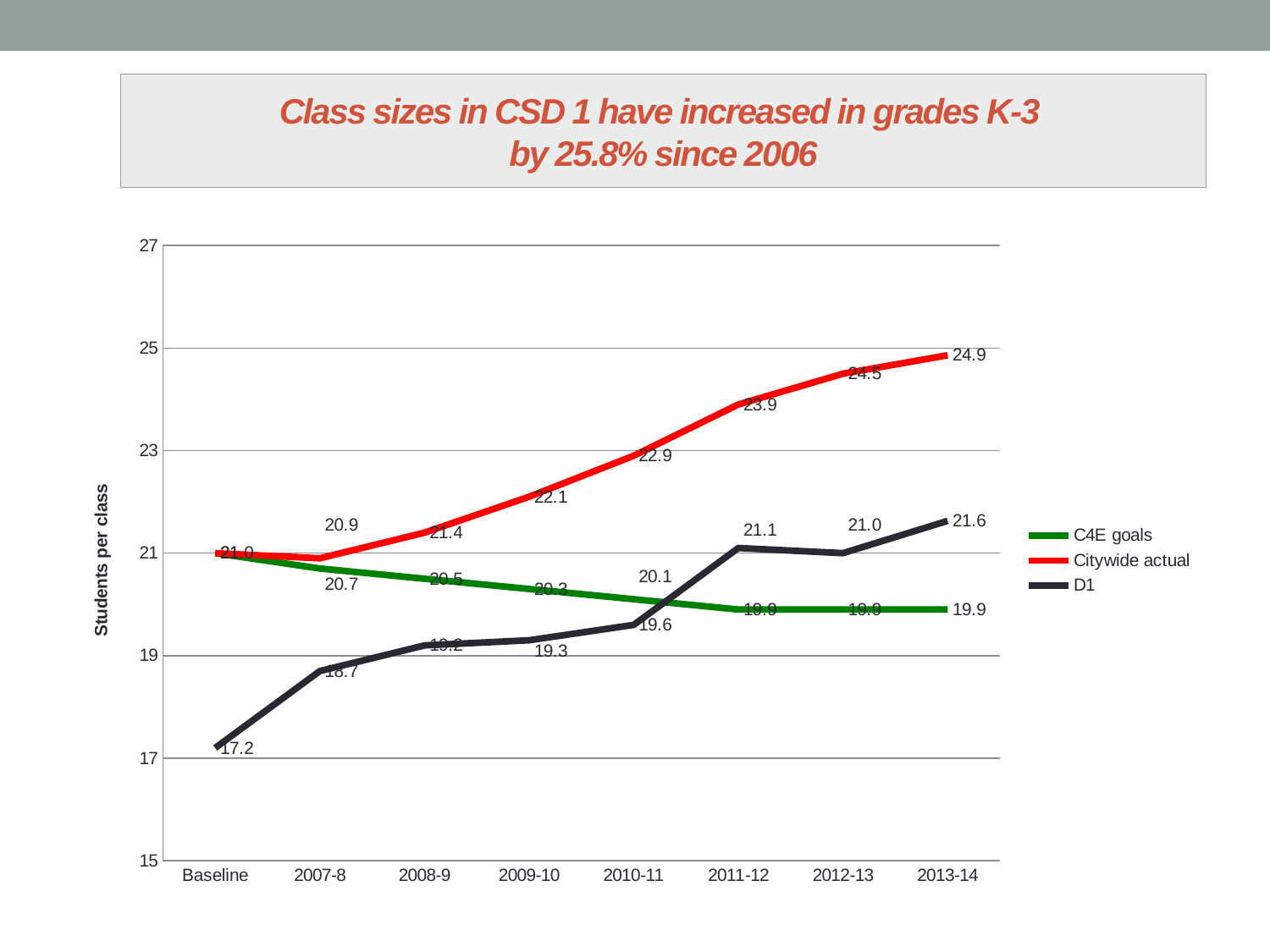
In which year is the D1 series at its lowest value? Baseline What is the Citywide actual value for 2013-14? 24.9 What is the Citywide actual value for 2010-11? 22.9 What is the C4E goals value for 2007-8? 20.7 Does the C4E goals series rise or fall from Baseline to 2013-14? Fall What is the D1 value for 2011-12? 21.1 What kind of chart is shown on the slide? Line chart Which is larger in 2012-13, the Citywide actual value or the D1 value? Citywide actual What is the difference between the Citywide actual value and the D1 value in 2013-14? 3.3 How many series does the legend list? 3 What is the D1 value at Baseline? 17.2 In which year does the Citywide actual series reach its highest value? 2013-14